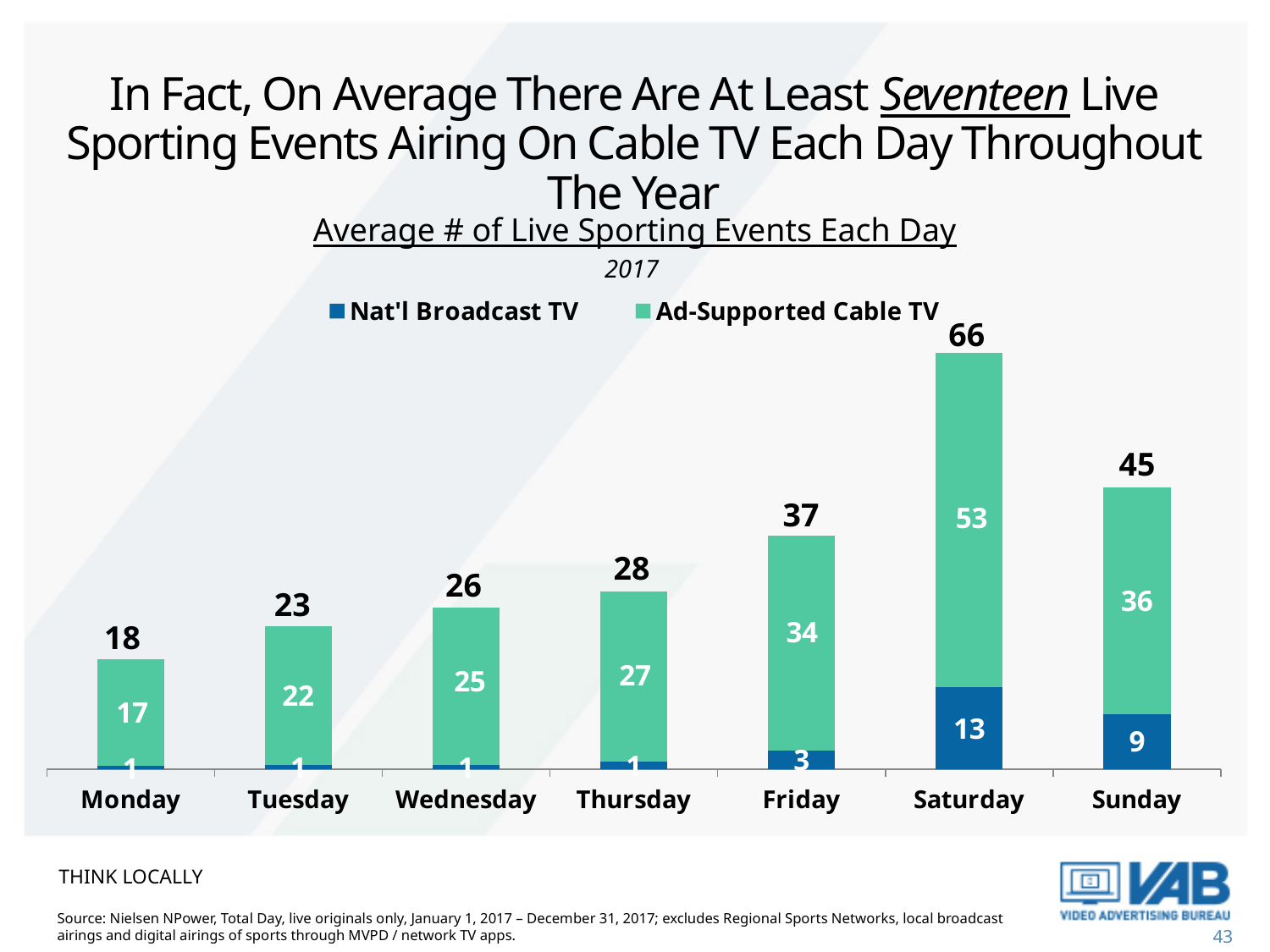
What is the Nat'l Broadcast TV value for Friday? 3 How many series does the legend list? 2 What is the difference between the Ad-Supported Cable TV values for Saturday and Sunday? 17 What is the total of the stacked bar for Sunday? 45 How many days are shown on the x axis? 7 Which day has the lowest total number of live sporting events? Monday Do the total values rise or fall from Monday to Saturday? Rise What kind of chart is shown on the slide? Stacked bar chart Which day has the highest total number of live sporting events? Saturday Which is larger, the Nat'l Broadcast TV value for Saturday or for Sunday? Saturday What is the Ad-Supported Cable TV value for Monday? 17 What is the Ad-Supported Cable TV value for Saturday? 53